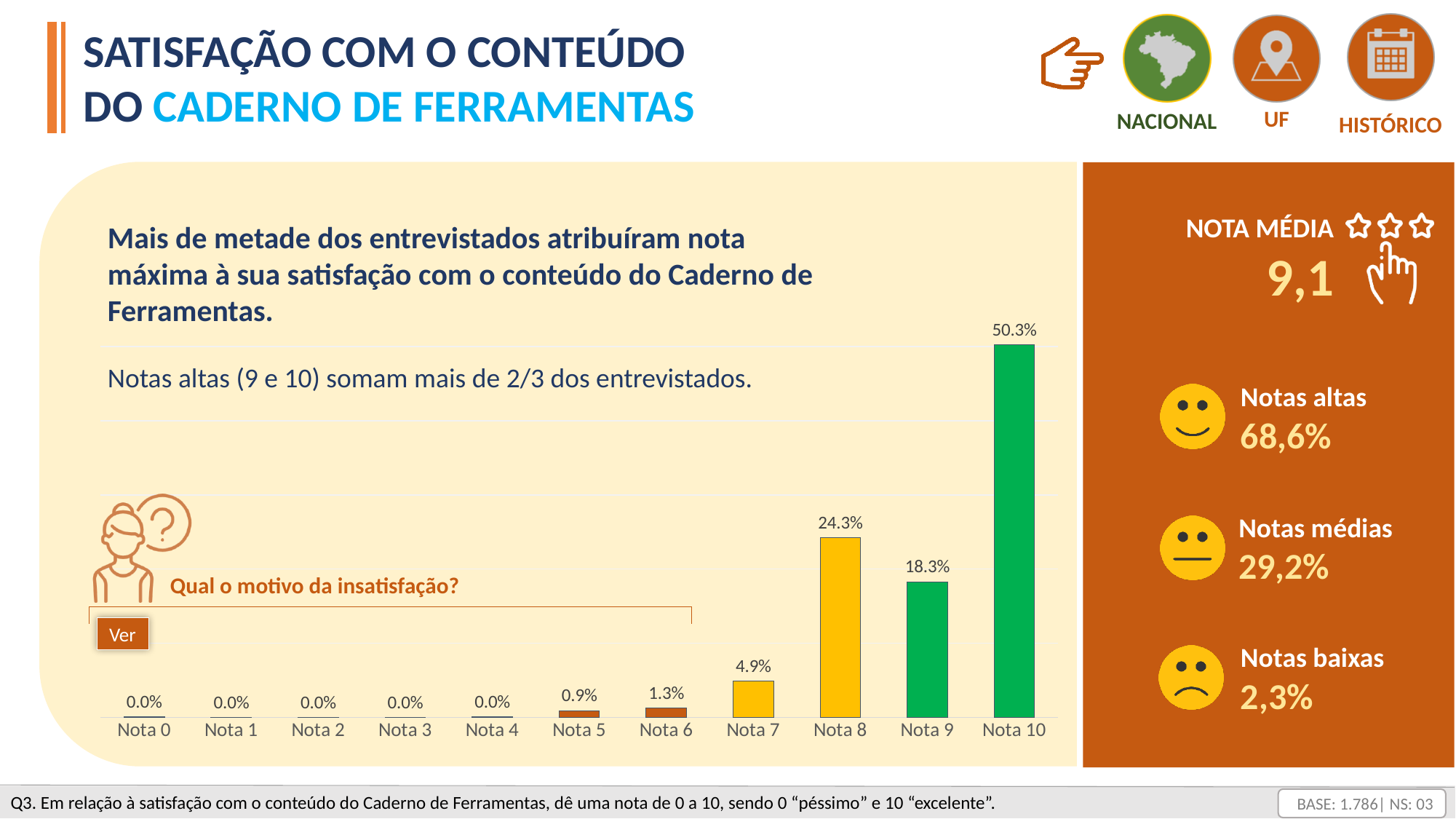
What kind of chart is shown? bar chart What is the value for Nota 8? 24.3% What is the value for Nota 10? 50.3% How many categories are shown on the x axis? 11 What is the difference between the values for Nota 10 and Nota 9? 32.0% What is the difference between the values for Nota 8 and Nota 7? 19.4% Which is larger, the value for Nota 8 or the value for Nota 9? Nota 8 Do the values rise or fall from Nota 5 to Nota 8? rise What is the value for Nota 5? 0.9% Which is larger, the value for Nota 6 or the value for Nota 5? Nota 6 How many categories have a value of 0.0%? 5 Which category has the highest value? Nota 10